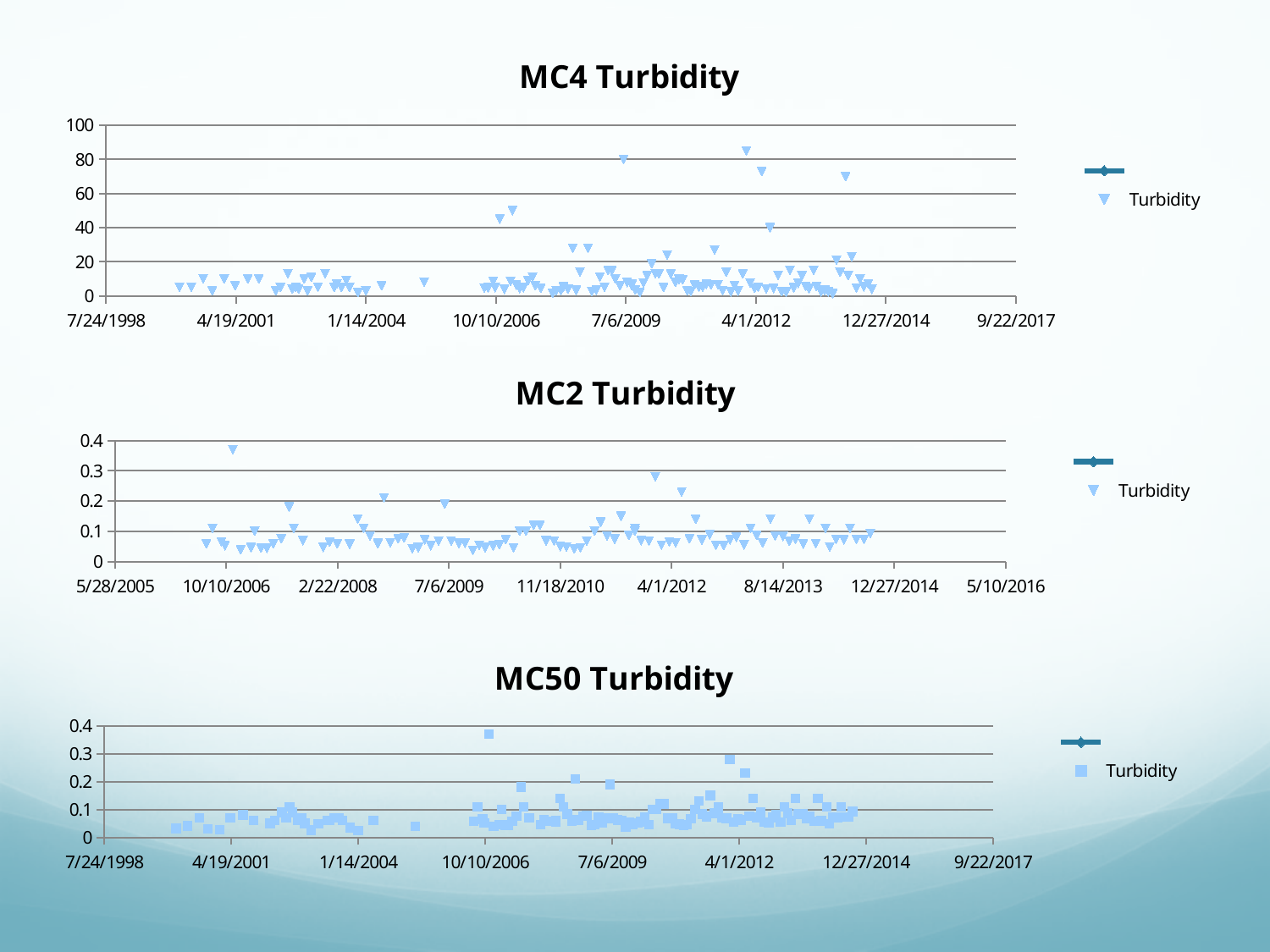
In the MC2 Turbidity chart, is the highest plotted value greater or less than 0.3? greater How many charts are shown on the slide? 3 What kind of chart is the MC4 Turbidity chart? scatter chart In the MC4 Turbidity chart, is the highest plotted value greater or less than 100? less What is the maximum value shown on the y axis of the MC4 Turbidity chart? 100 In the MC50 Turbidity chart, is the highest plotted value greater or less than 0.4? less In the MC2 Turbidity chart, what series name does the legend show? Turbidity What is the title of the top chart on the slide? MC4 Turbidity In the MC4 Turbidity chart, which is larger: the peak value plotted near 4/1/2012 or the peak value plotted near 12/27/2014? the peak near 4/1/2012